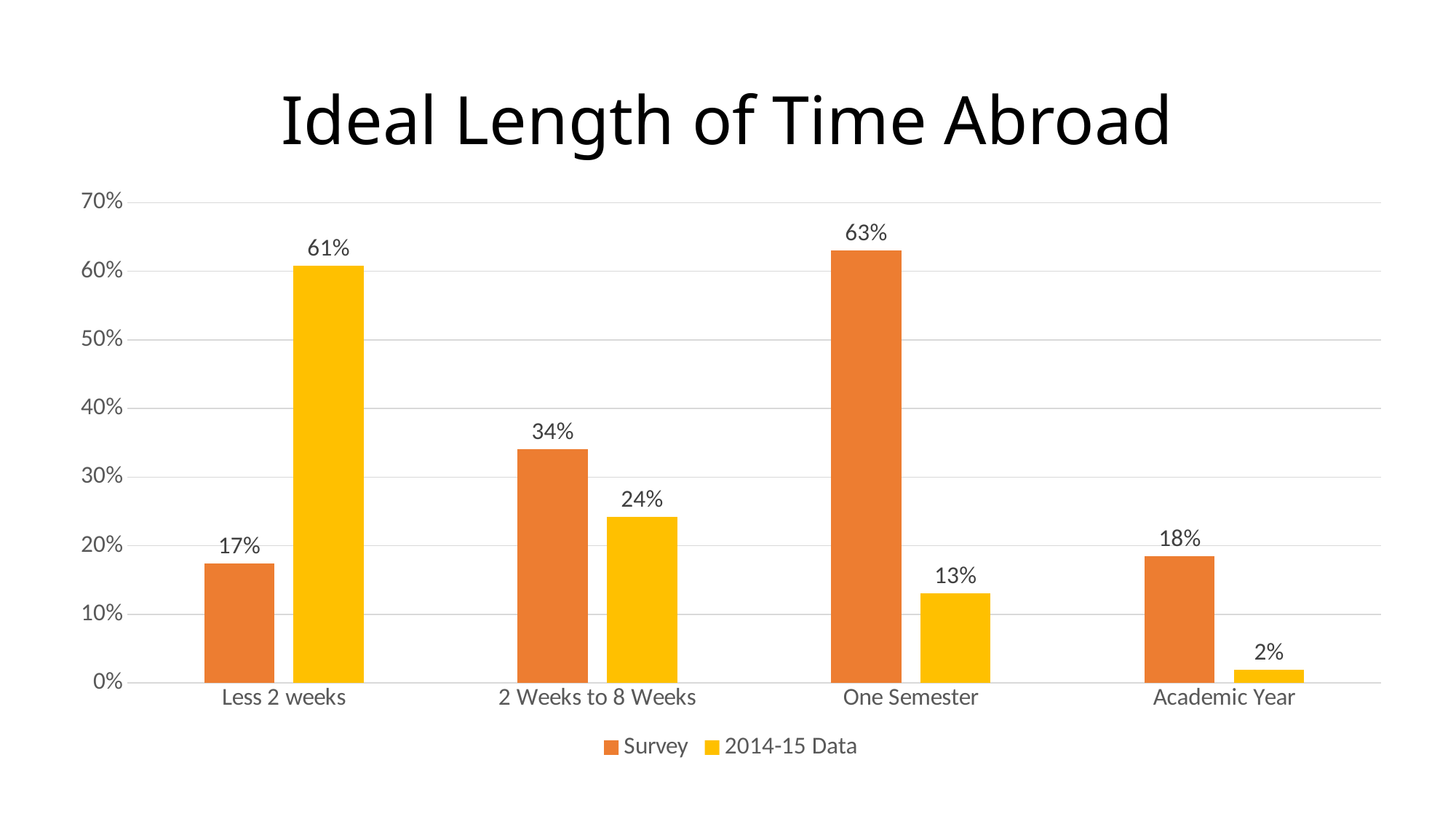
How many series does the legend list? 2 Which is larger for 2 Weeks to 8 Weeks: the Survey value or the 2014-15 Data value? Survey What is the 2014-15 Data value for Less 2 weeks? 61% What is the title of the chart? Ideal Length of Time Abroad What is the difference between the Survey and 2014-15 Data values for Less 2 weeks? 44% What kind of chart is shown on the slide? Bar chart How many categories are shown on the x axis? 4 What is the Survey value for One Semester? 63% What is the 2014-15 Data value for 2 Weeks to 8 Weeks? 24% What is the Survey value for Academic Year? 18% Which category has the highest Survey value? One Semester Which category has the lowest 2014-15 Data value? Academic Year